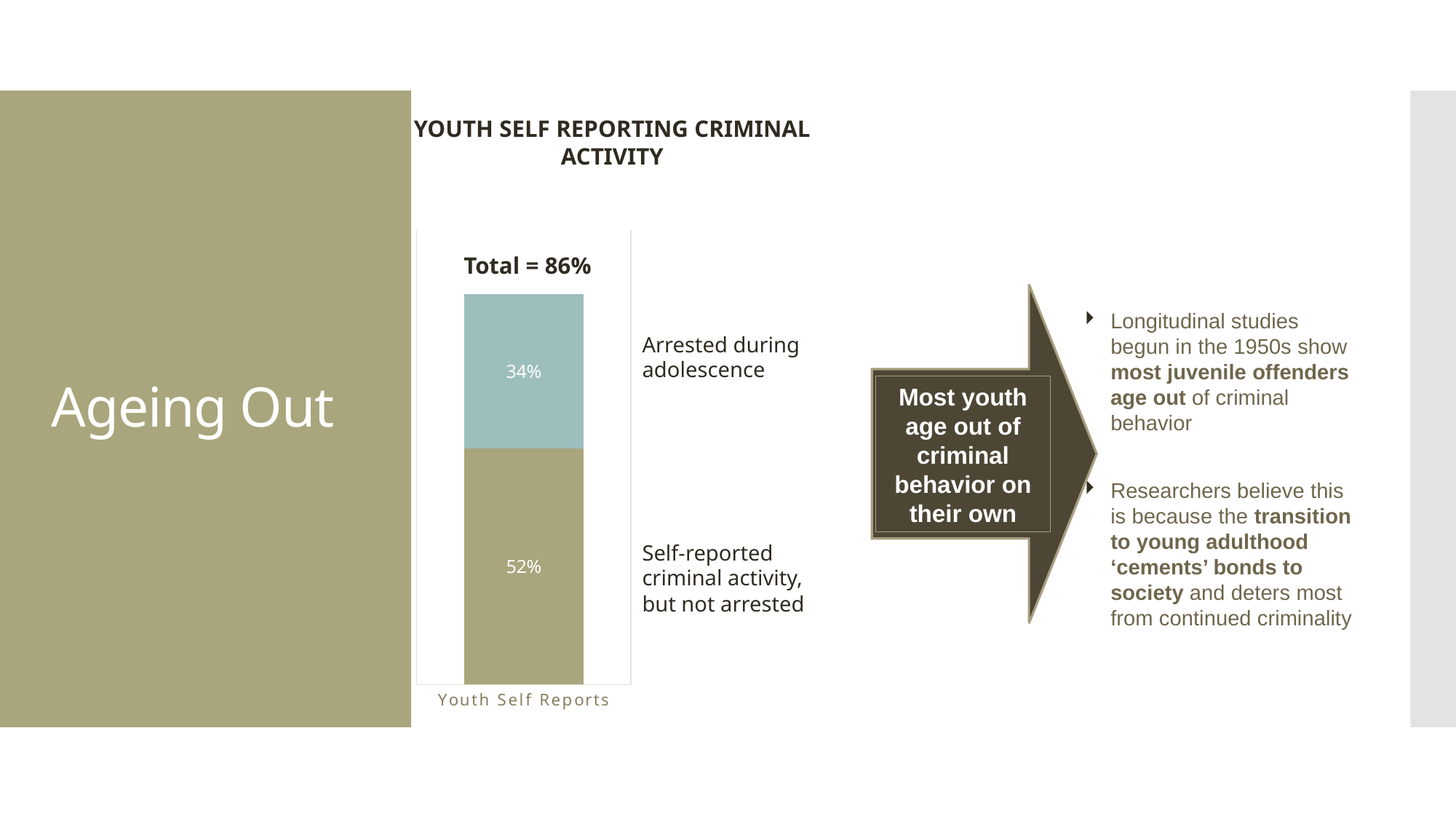
What type of chart is shown on the slide? Stacked bar chart How many bars are plotted in the chart? 1 What is the category label shown beneath the bar? Youth Self Reports What is the total shown for the stacked bar? 86% How many segments make up the stacked bar? 2 What percentage of youth self-reported criminal activity but were not arrested? 52% Which segment is larger: arrested during adolescence or self-reported criminal activity but not arrested? Self-reported criminal activity, but not arrested What percentage of youth were arrested during adolescence? 34% Which segment of the bar is the largest? Self-reported criminal activity, but not arrested What is the title of the chart? Youth Self Reporting Criminal Activity Which segment of the bar is the smallest? Arrested during adolescence What is the difference between the self-reported but not arrested segment and the arrested during adolescence segment? 18%